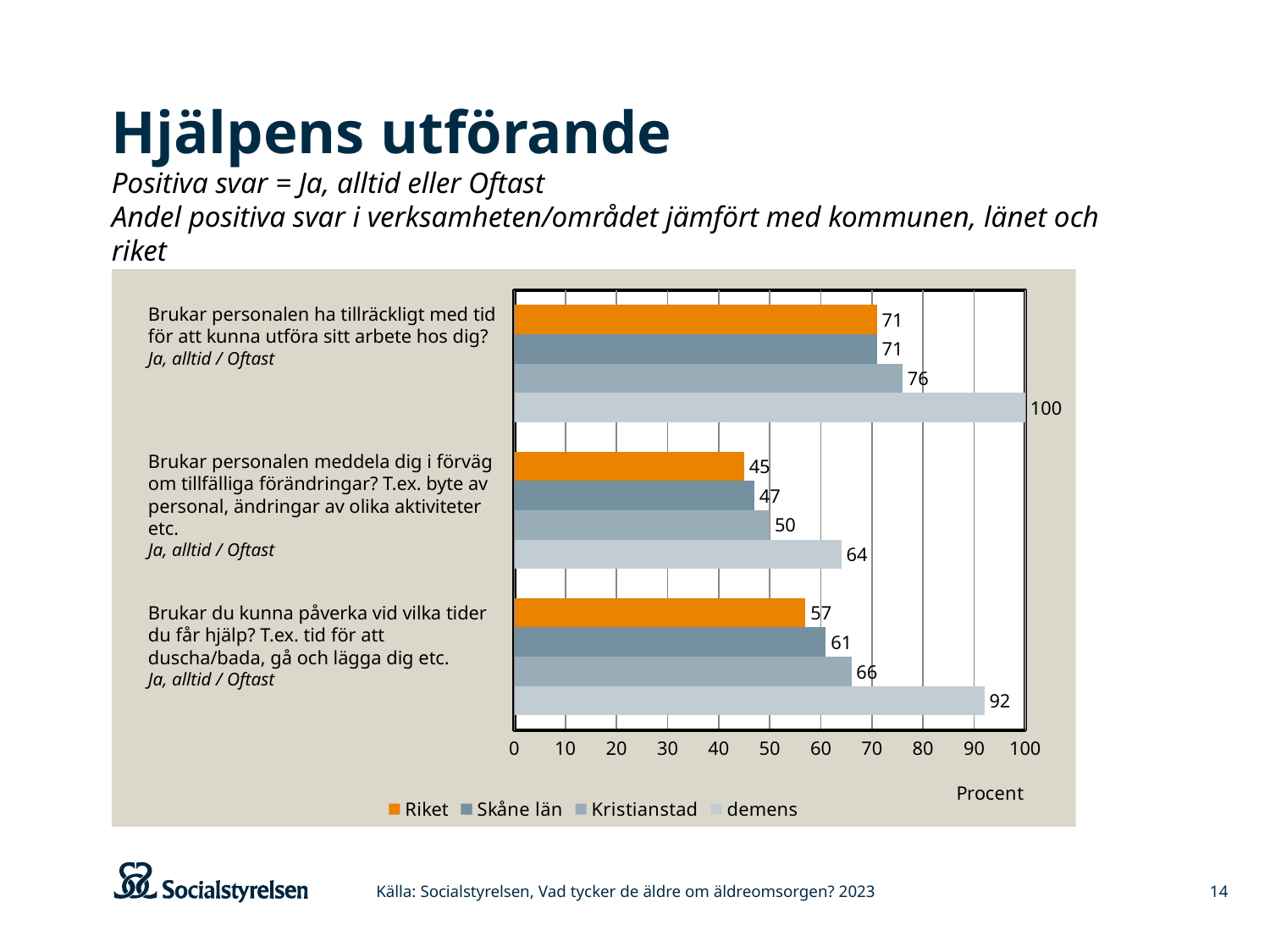
What is the value for 'Kristianstad' for the question 'Brukar du kunna påverka vid vilka tider du får hjälp?' 66 What is the difference between the 'demens' and 'Riket' values for the question 'Brukar du kunna påverka vid vilka tider du får hjälp?' 35 Which is larger: the 'Kristianstad' value for 'Brukar personalen ha tillräckligt med tid...' or the 'Kristianstad' value for 'Brukar personalen meddela dig i förväg...'? Brukar personalen ha tillräckligt med tid... How many series does the legend list? 4 What is the value for 'demens' for the question 'Brukar personalen ha tillräckligt med tid för att kunna utföra sitt arbete hos dig?' 100 What is the label of the x axis? Procent Which series has the highest value for the question 'Brukar personalen meddela dig i förväg om tillfälliga förändringar?' demens What is the value for 'Riket' for the question 'Brukar personalen meddela dig i förväg om tillfälliga förändringar?' 45 What kind of chart is shown on the slide? bar chart How many question categories are plotted on the chart? 3 What is the value for 'Skåne län' for the question 'Brukar du kunna påverka vid vilka tider du får hjälp?' 61 Which series has the lowest value for the question 'Brukar du kunna påverka vid vilka tider du får hjälp?' Riket